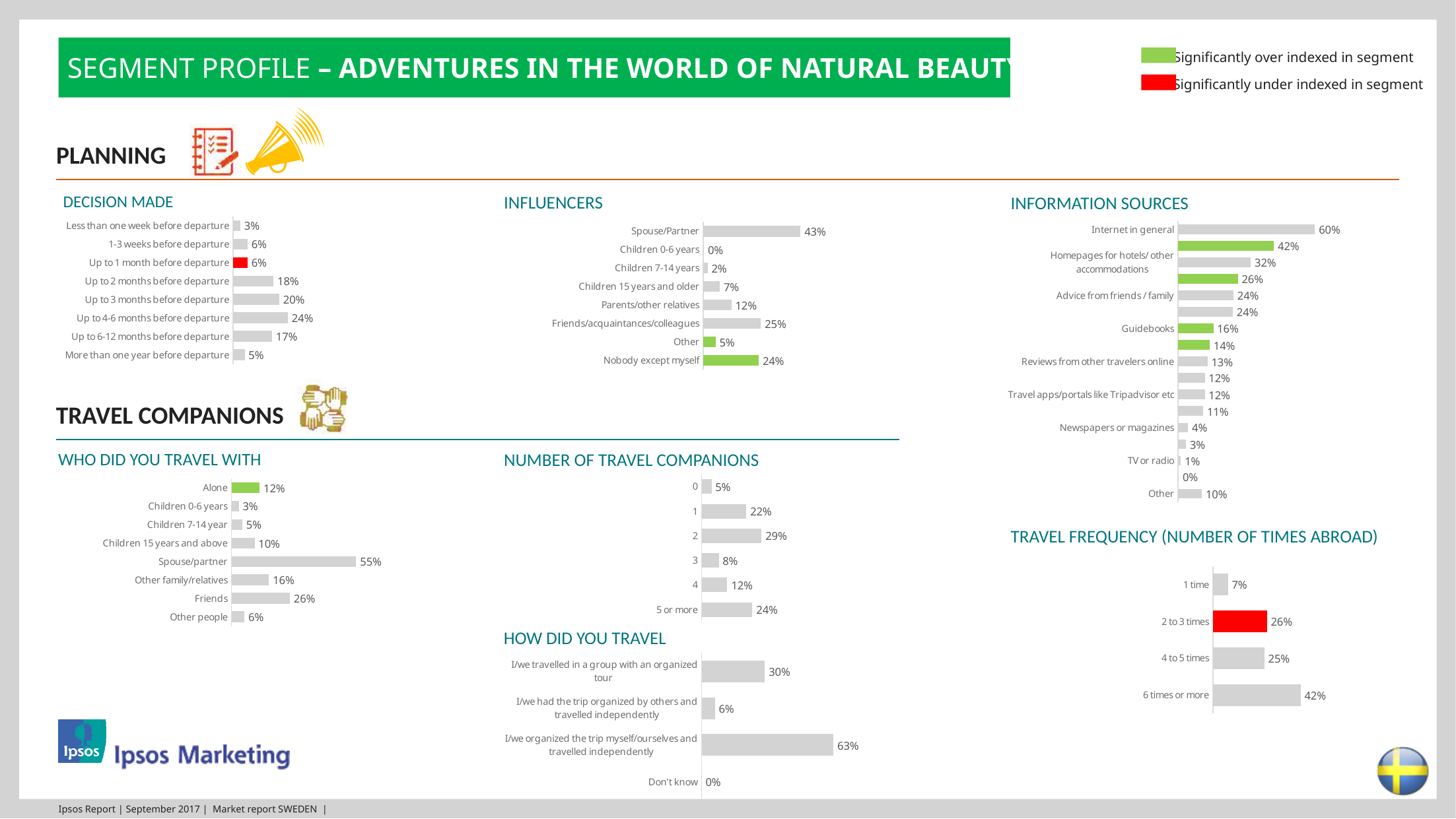
In the 'Influencers' chart, what is the value for 'Spouse/Partner'? 43% In the 'Information sources' chart, which category has the highest value? Internet in general In the 'Travel frequency (number of times abroad)' chart, what is the difference between '6 times or more' and '1 time'? 35% In the 'Influencers' chart, what is the difference between 'Friends/acquaintances/colleagues' and 'Parents/other relatives'? 13% In the 'Number of travel companions' chart, which category has the highest value? 2 In the 'Decision made' chart, which category has the lowest value? Less than one week before departure In the 'Who did you travel with' chart, which is larger: 'Other family/relatives' or 'Children 15 years and above'? Other family/relatives In the 'Influencers' chart, how many categories are shown? 8 In the 'Decision made' chart, what is the value for 'Up to 4-6 months before departure'? 24% In the 'Who did you travel with' chart, what is the value for 'Friends'? 26% In the 'How did you travel' chart, what is the value for 'I/we organized the trip myself/ourselves and travelled independently'? 63% What type of chart is the 'Travel frequency (number of times abroad)' chart? Bar chart